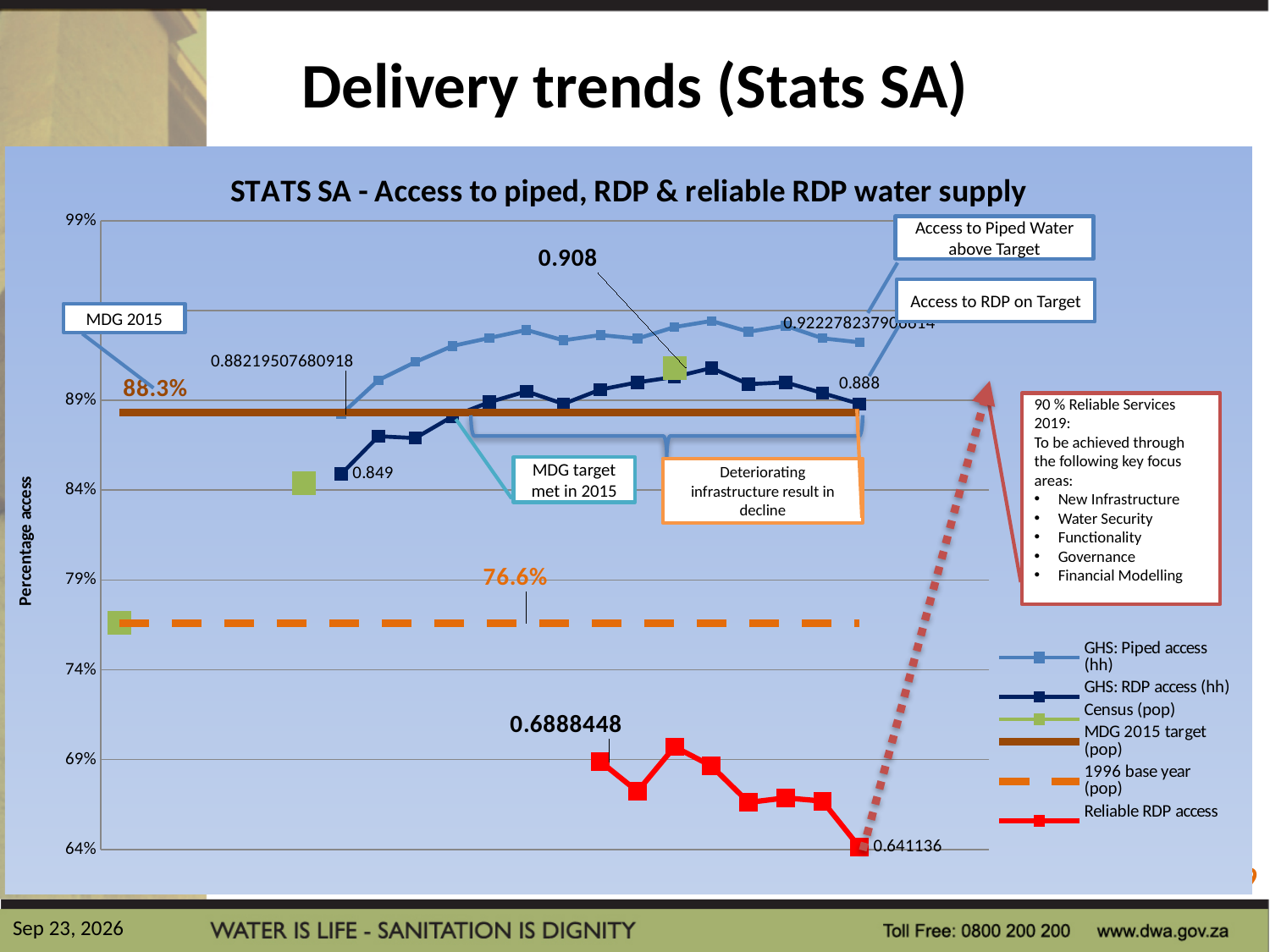
What is the highest labelled Census (pop) value? 0.908 What is the labelled value of the last Reliable RDP access point? 0.641136 What kind of chart is shown on the slide? line chart What is the labelled value of the first Reliable RDP access point? 0.6888448 How many series does the legend list? 6 Is the last Reliable RDP access point greater or less than 69%? less Does the Reliable RDP access series rise or fall overall along the x axis? fall What is the value of the 1996 base year (pop) line? 76.6% What is the difference between the last and first labelled GHS: RDP access (hh) values (0.888 and 0.849)? 0.039 What is the value of the MDG 2015 target (pop) line? 88.3% What is the labelled value of the first GHS: RDP access (hh) point? 0.849 What is the labelled value of the last GHS: RDP access (hh) point? 0.888